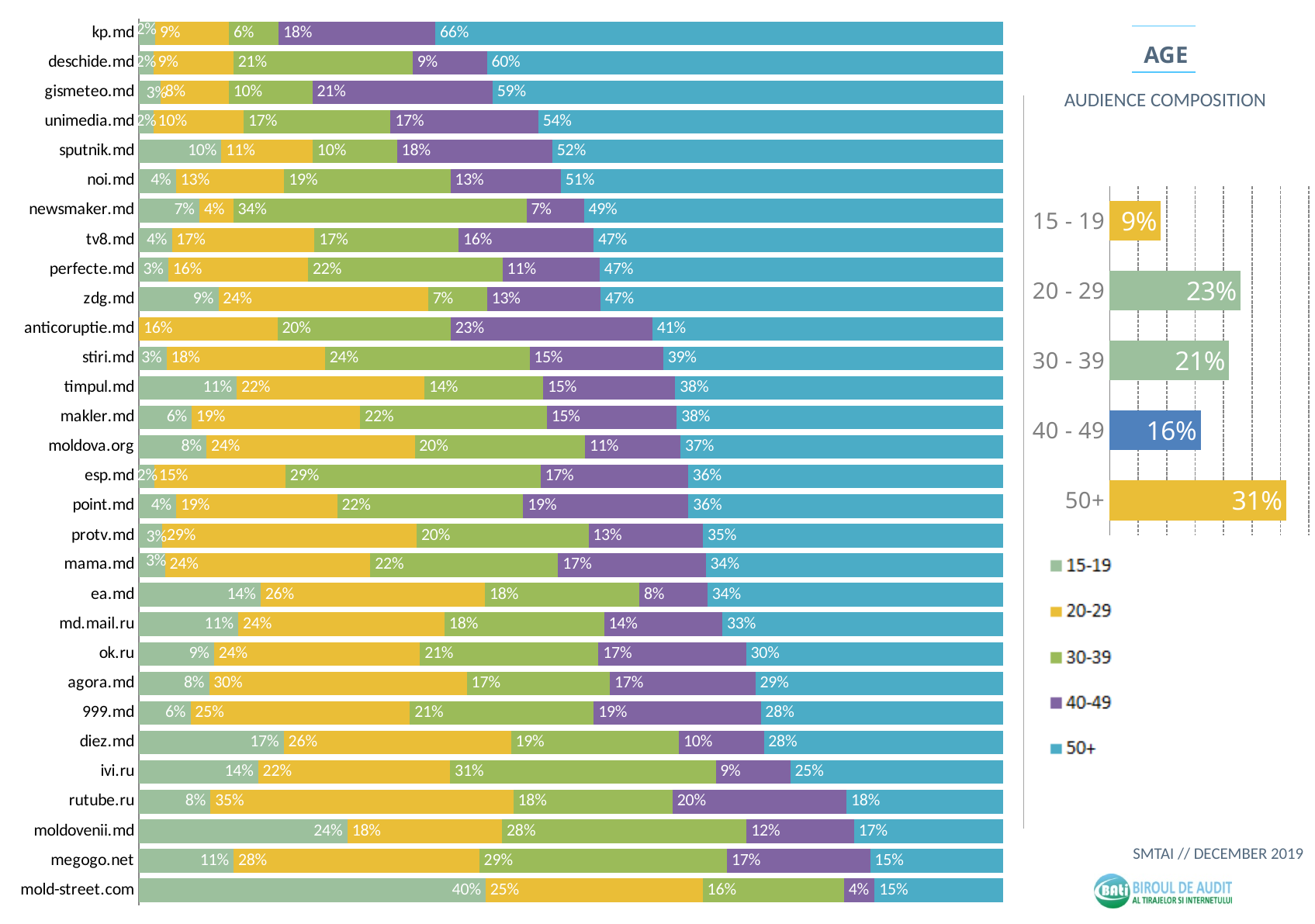
In the left-hand stacked bar chart of websites, which website has the highest 50+ share? kp.md In the right-hand AGE audience composition chart, what is the difference between the 20 - 29 and 40 - 49 shares? 7% In the left-hand stacked bar chart of websites, what is the 15-19 share for mold-street.com? 40% In the left-hand stacked bar chart of websites, what is the 50+ share for kp.md? 66% What type of chart is the left-hand chart of websites? Stacked bar chart In the left-hand stacked bar chart of websites, is the 30-39 share larger for newsmaker.md or for kp.md? newsmaker.md In the right-hand AGE audience composition chart, which age group has the lowest share? 15 - 19 In the right-hand AGE audience composition chart, which age group has the highest share? 50+ In the right-hand AGE audience composition chart, what is the value for the 50+ age group? 31% In the right-hand AGE audience composition chart, how many age groups are shown? 5 In the left-hand stacked bar chart of websites, how many websites are listed? 30 In the left-hand stacked bar chart of websites, how many series does the legend list? 5